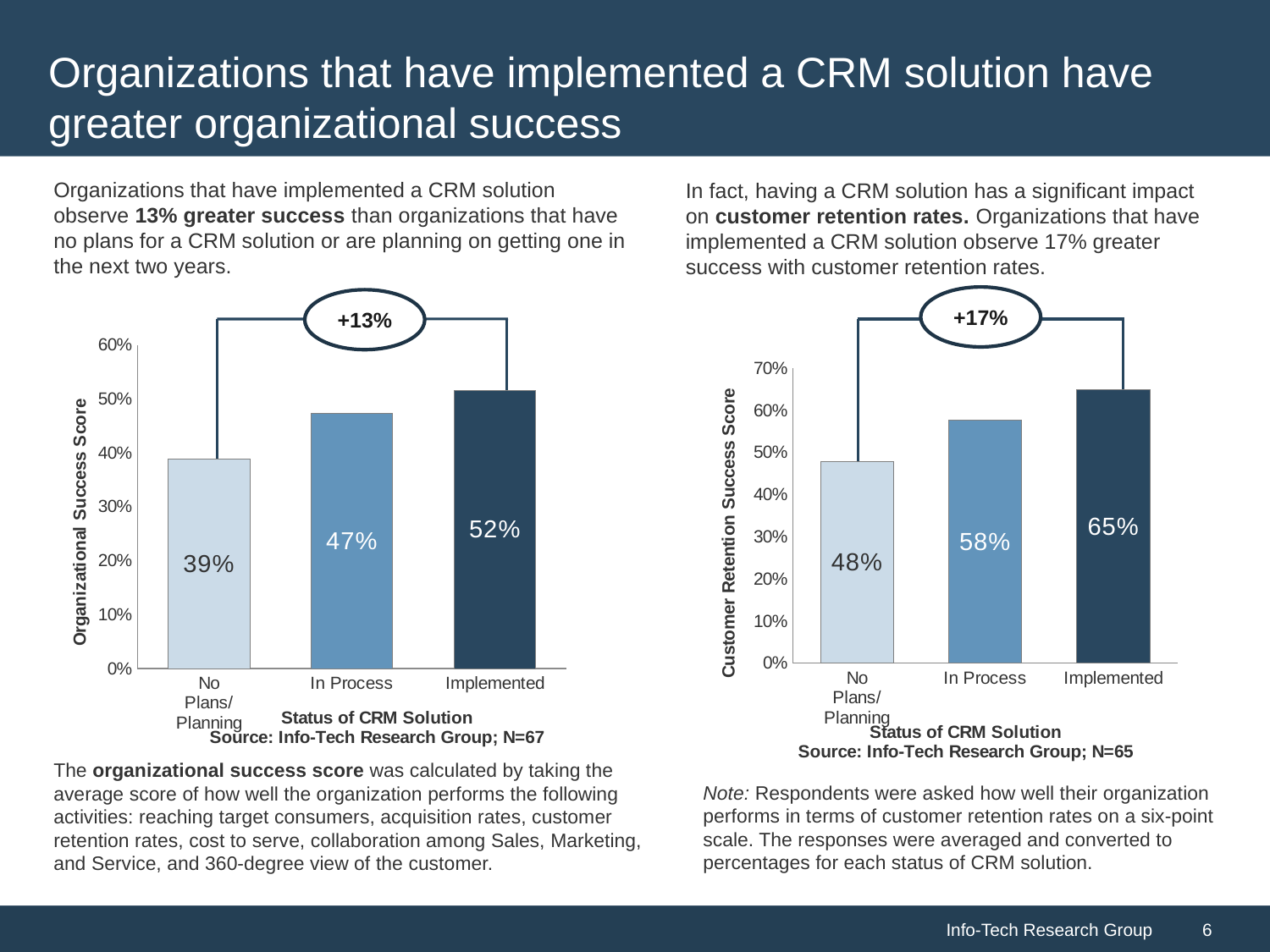
In the left chart (Organizational Success Score), what is the value for No Plans/Planning? 39% In the right chart (Customer Retention Success Score), is the value for No Plans/Planning greater or less than 50%? less In the right chart (Customer Retention Success Score), what is the difference between Implemented and No Plans/Planning? 17% What kind of chart is the right chart (Customer Retention Success Score)? bar chart In the right chart (Customer Retention Success Score), do the values rise or fall from No Plans/Planning to Implemented? rise How many categories are shown on the x axis of the left chart (Organizational Success Score)? 3 In the right chart (Customer Retention Success Score), which status of CRM solution has the highest value? Implemented In the left chart (Organizational Success Score), what is the value for Implemented? 52% In the left chart (Organizational Success Score), which status of CRM solution has the lowest value? No Plans/Planning In the left chart (Organizational Success Score), what is the difference between In Process and No Plans/Planning? 8% In the left chart (Organizational Success Score), which is larger, In Process or Implemented? Implemented In the right chart (Customer Retention Success Score), what is the value for In Process? 58%